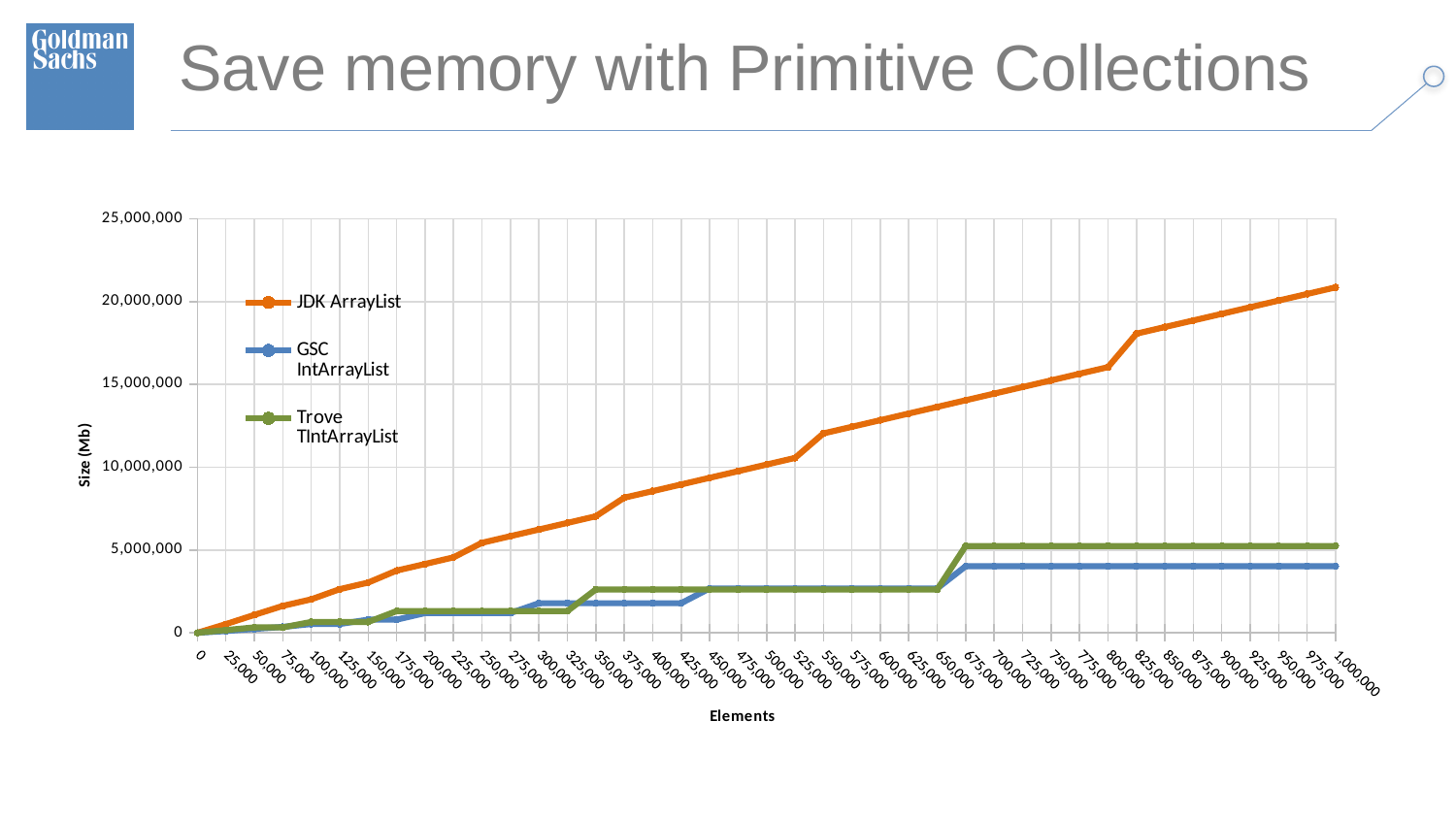
What kind of chart is shown on the slide? Line chart At 1,000,000 elements, which is larger: Trove TIntArrayList or GSC IntArrayList? Trove TIntArrayList Is the value for JDK ArrayList at 1,000,000 elements greater or less than 20,000,000? greater What is the label of the vertical axis? Size (Mb) Is the value for JDK ArrayList at 550,000 elements greater or less than 10,000,000? greater What colour is the JDK ArrayList line? Orange Is the value for Trove TIntArrayList at 500,000 elements greater or less than 5,000,000? less Which series has the highest value at 1,000,000 elements? JDK ArrayList Which series has the lowest value at 1,000,000 elements? GSC IntArrayList How many series does the legend list? 3 Does the JDK ArrayList series rise or fall as the number of elements increases? Rises